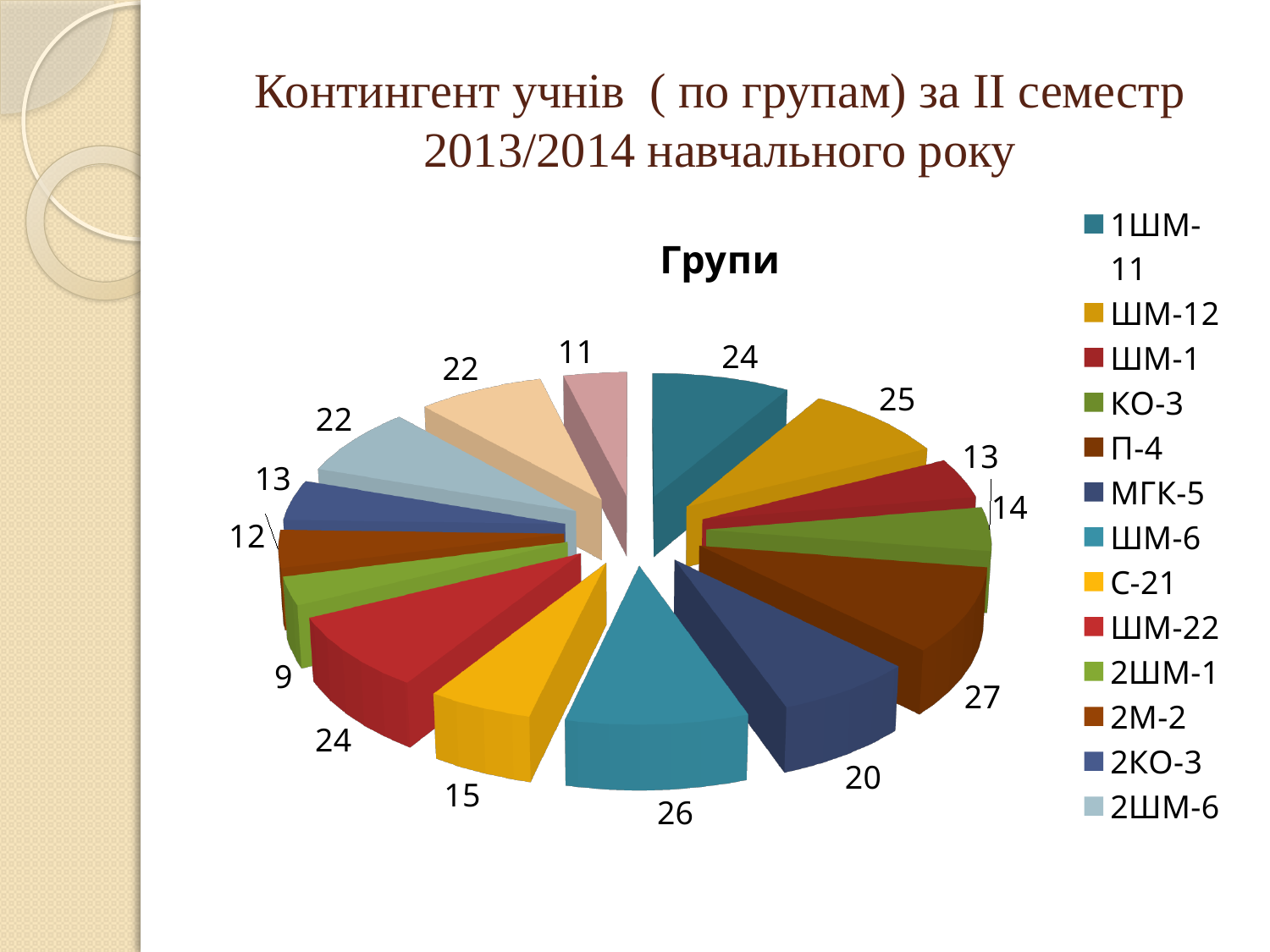
What is the title of the pie chart? Групи What kind of chart is shown on the slide? pie chart What is the difference between the values for ШМ-12 and ШМ-1? 12 Which is larger, the value for МГК-5 or the value for С-21? МГК-5 What is the value for КО-3 in the pie chart? 14 What is the value for П-4 in the pie chart? 27 How many slices does the pie chart have? 15 Which group has the smallest slice in the pie chart? 2ШМ-1 Which group has the largest slice in the pie chart? П-4 What is the value for 2ШМ-1 in the pie chart? 9 What is the difference between the largest value (П-4) and the smallest value (2ШМ-1)? 18 What is the value for ШМ-6 in the pie chart? 26